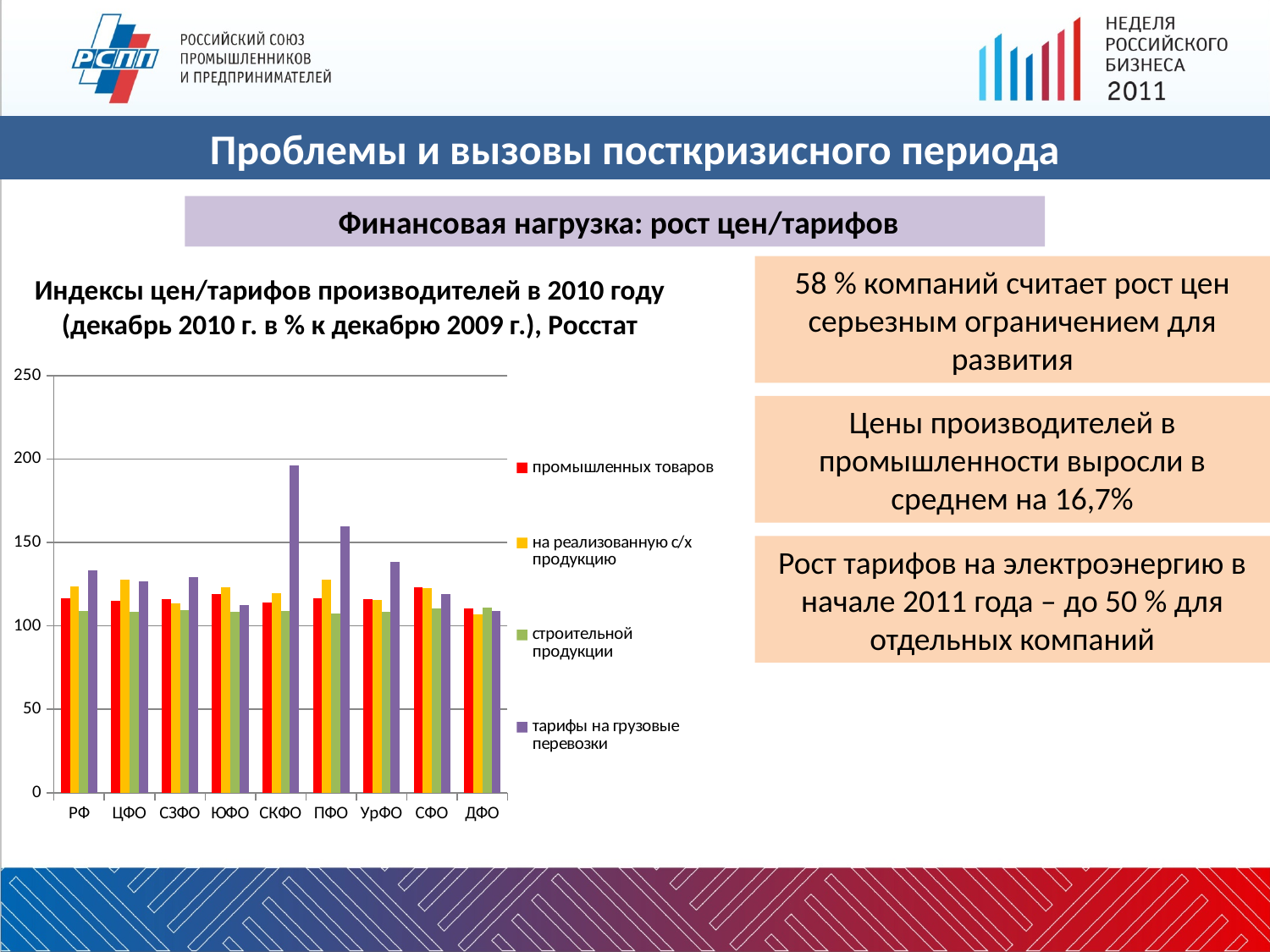
For РФ, which is larger: 'промышленных товаров' or 'тарифы на грузовые перевозки'? тарифы на грузовые перевозки Is the value of 'тарифы на грузовые перевозки' for ПФО greater or less than 150? greater Which series is shown in red in the chart legend? промышленных товаров For which region is the 'тарифы на грузовые перевозки' bar the highest? СКФО Is the value of 'тарифы на грузовые перевозки' for СКФО greater or less than 150? greater Which is larger: 'тарифы на грузовые перевозки' for СКФО or for ПФО? СКФО Is the value of 'тарифы на грузовые перевозки' for СКФО greater or less than 200? less How many regions (categories) are shown on the x axis of the chart? 9 What kind of chart is shown on the slide? bar chart How many series does the chart legend list? 4 What is the title of the chart? Индексы цен/тарифов производителей в 2010 году (декабрь 2010 г. в % к декабрю 2009 г.), Росстат